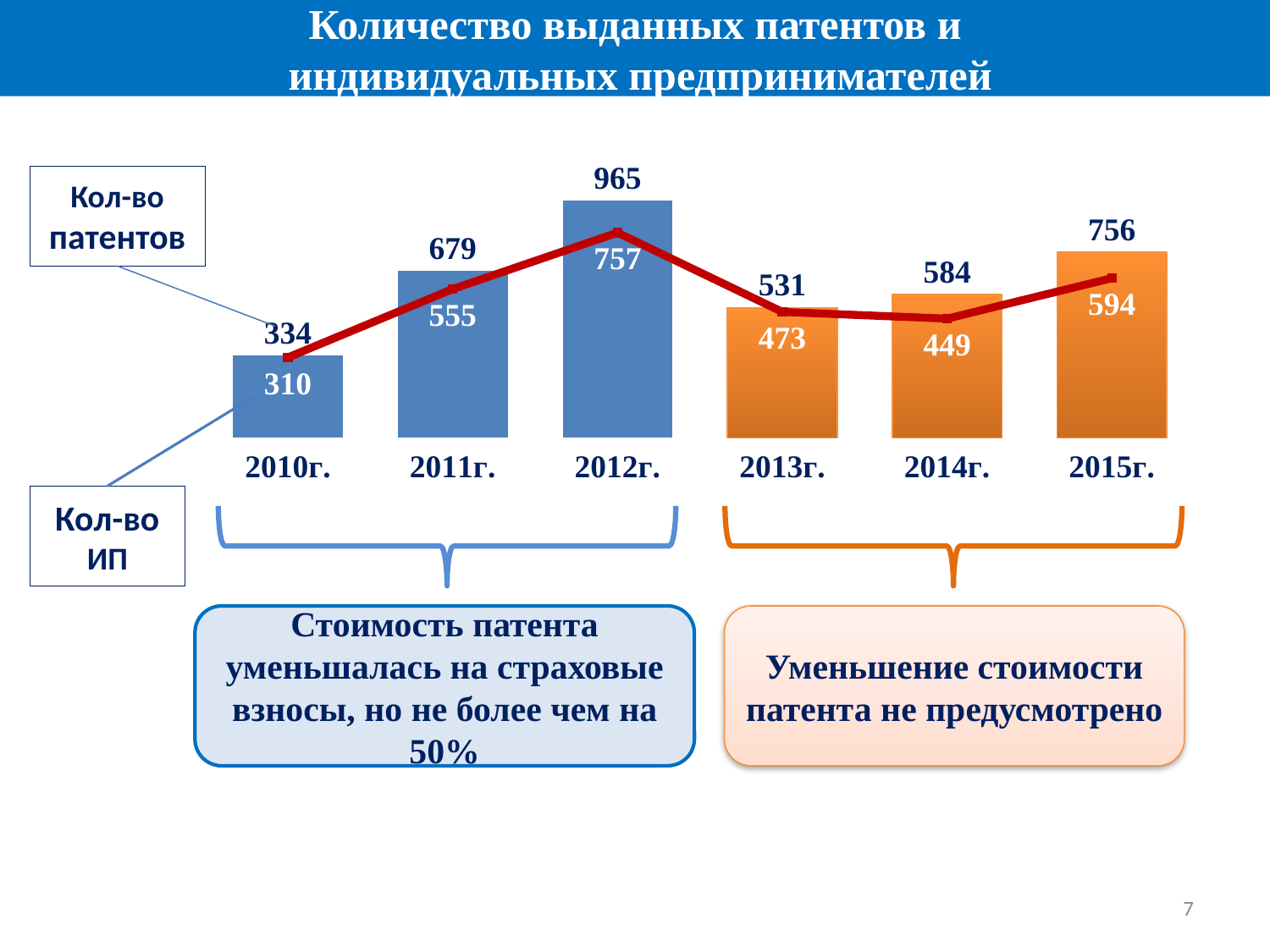
Does the number of patents rise or fall from 2013г. to 2015г.? Rise What is the difference in the number of patents between 2012г. and 2013г.? 434 Which year has the lowest number of individual entrepreneurs (Кол-во ИП)? 2010г. How many years are shown on the x axis of the chart? 6 What is the difference between the number of patents and the number of individual entrepreneurs in 2013г.? 58 What is the number of individual entrepreneurs (Кол-во ИП) for 2014г.? 449 How many data series does the chart show? 2 What is the number of patents (Кол-во патентов) for 2015г.? 756 What is the number of patents (Кол-во патентов) for 2012г.? 965 Which year has the highest number of patents (Кол-во патентов)? 2012г. Which is larger: the number of patents in 2011г. or in 2014г.? 2011г. What kind of chart is shown on the slide? Combined bar and line chart